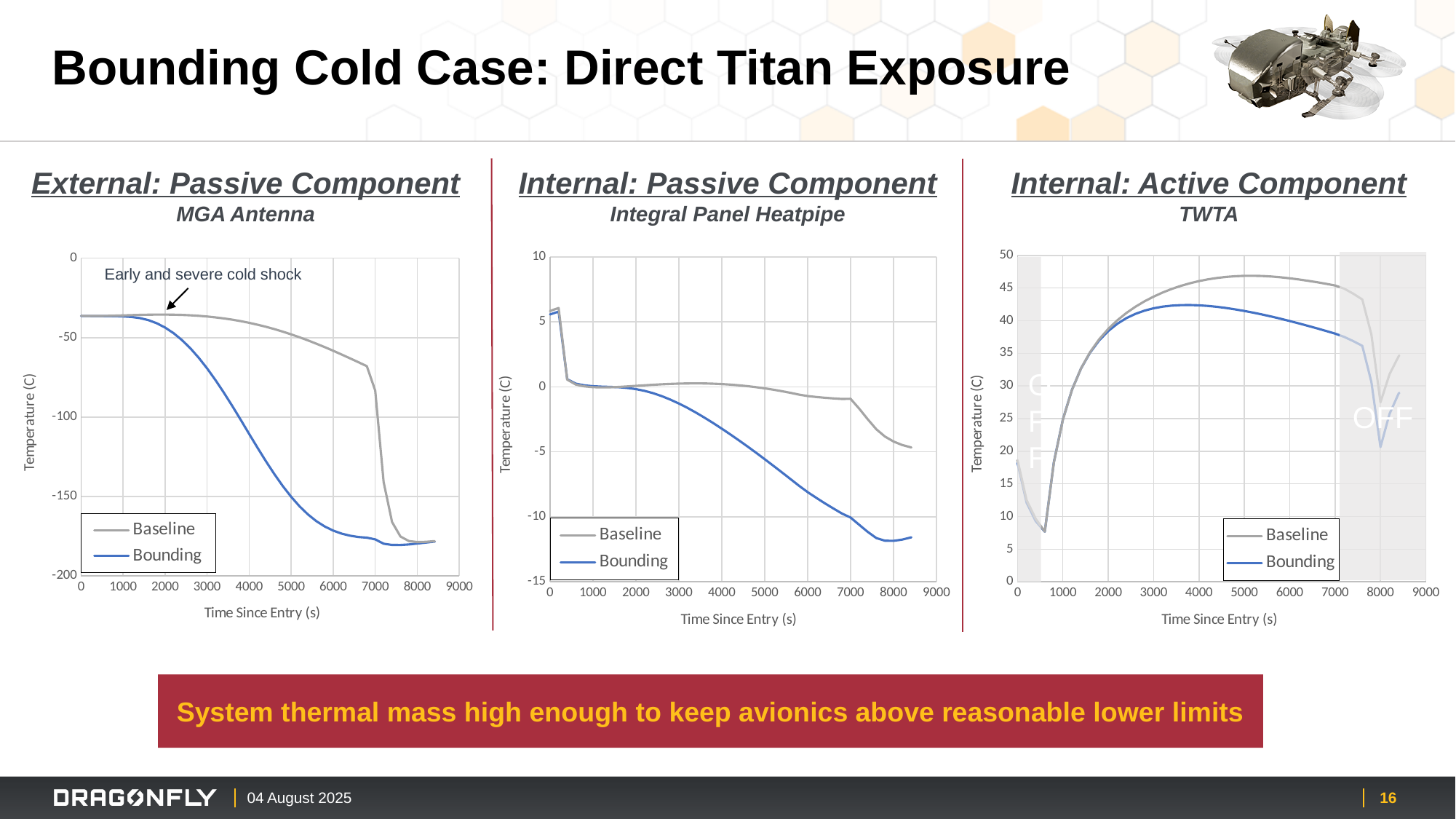
How many series does the legend of the Integral Panel Heatpipe chart list? 2 In the MGA Antenna chart, does the Baseline series rise or fall overall from 0 s to 8000 s? fall What kind of chart is the MGA Antenna chart? line chart In the MGA Antenna chart, which series is higher at 6000 s, Baseline or Bounding? Baseline In the MGA Antenna chart, is the Baseline value at 4000 s greater or less than -50? greater In the Integral Panel Heatpipe chart, is the Bounding value at 6000 s greater or less than -5? less In the MGA Antenna chart, is the Bounding value at 4000 s greater or less than -100? less In the Integral Panel Heatpipe chart, which series ends lower at the right end of the x axis, Baseline or Bounding? Bounding What is the x-axis label on the MGA Antenna chart? Time Since Entry (s) What are the two series named in the legend of the TWTA chart? Baseline and Bounding